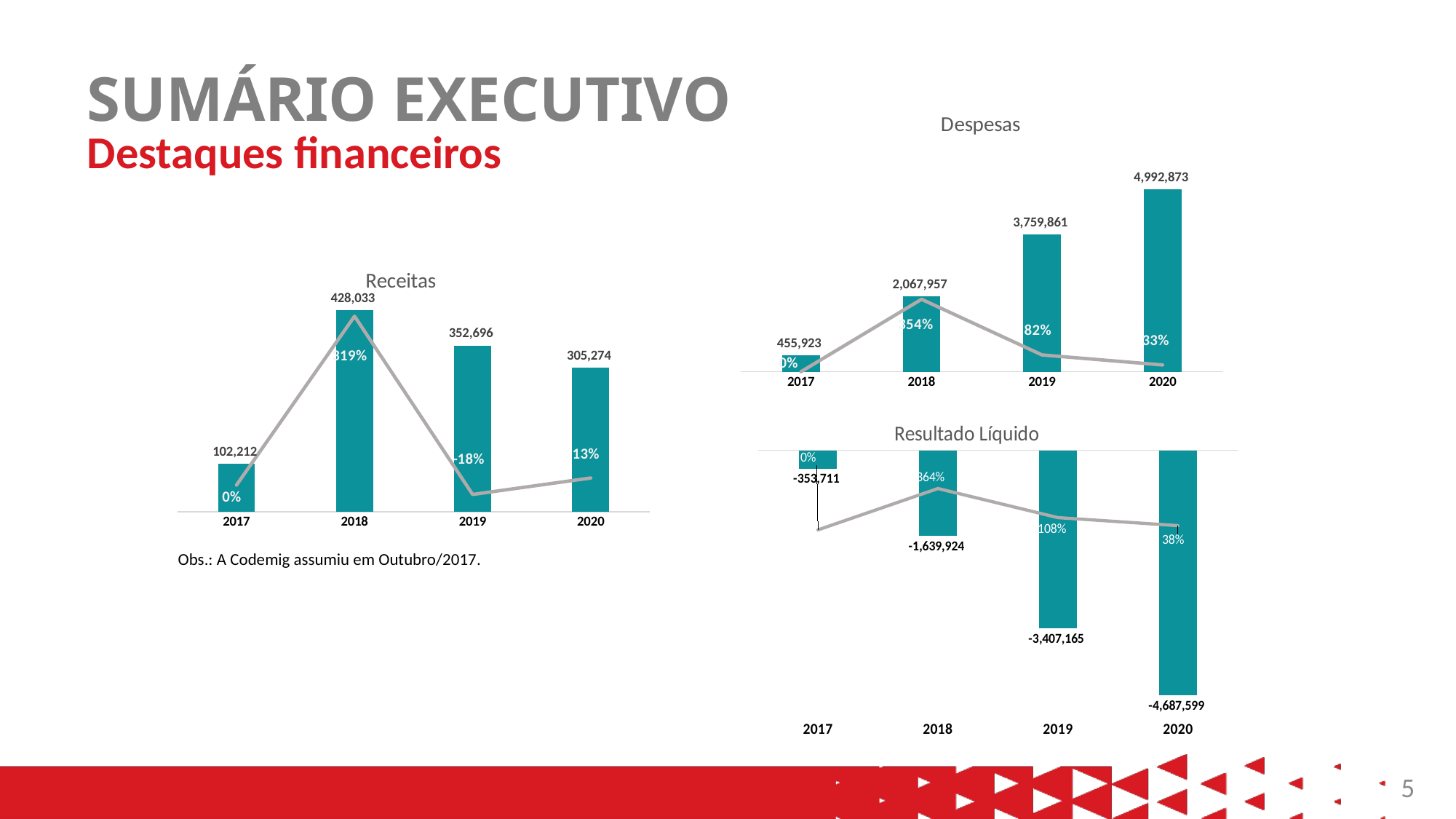
In the Despesas chart, what is the difference between the 2019 and 2018 values? 1,691,904 In the Resultado Líquido chart, which year has the lowest value? 2020 In the Receitas chart, what percentage change is shown on the 2019 bar? -18% How many years are shown on the x axis of the Receitas chart? 4 What type of chart is the Resultado Líquido chart? combination bar and line chart In the Despesas chart, do the bar values rise or fall from 2017 to 2020? rise In the Despesas chart, which year has the highest value? 2020 In the Receitas chart, what is the difference between the 2018 and 2019 values? 75,337 In the Receitas chart, what is the value for 2018? 428,033 In the Resultado Líquido chart, what is the value for 2019? -3,407,165 In the Despesas chart, what is the value for 2020? 4,992,873 In the Receitas chart, which year has the lowest value? 2017